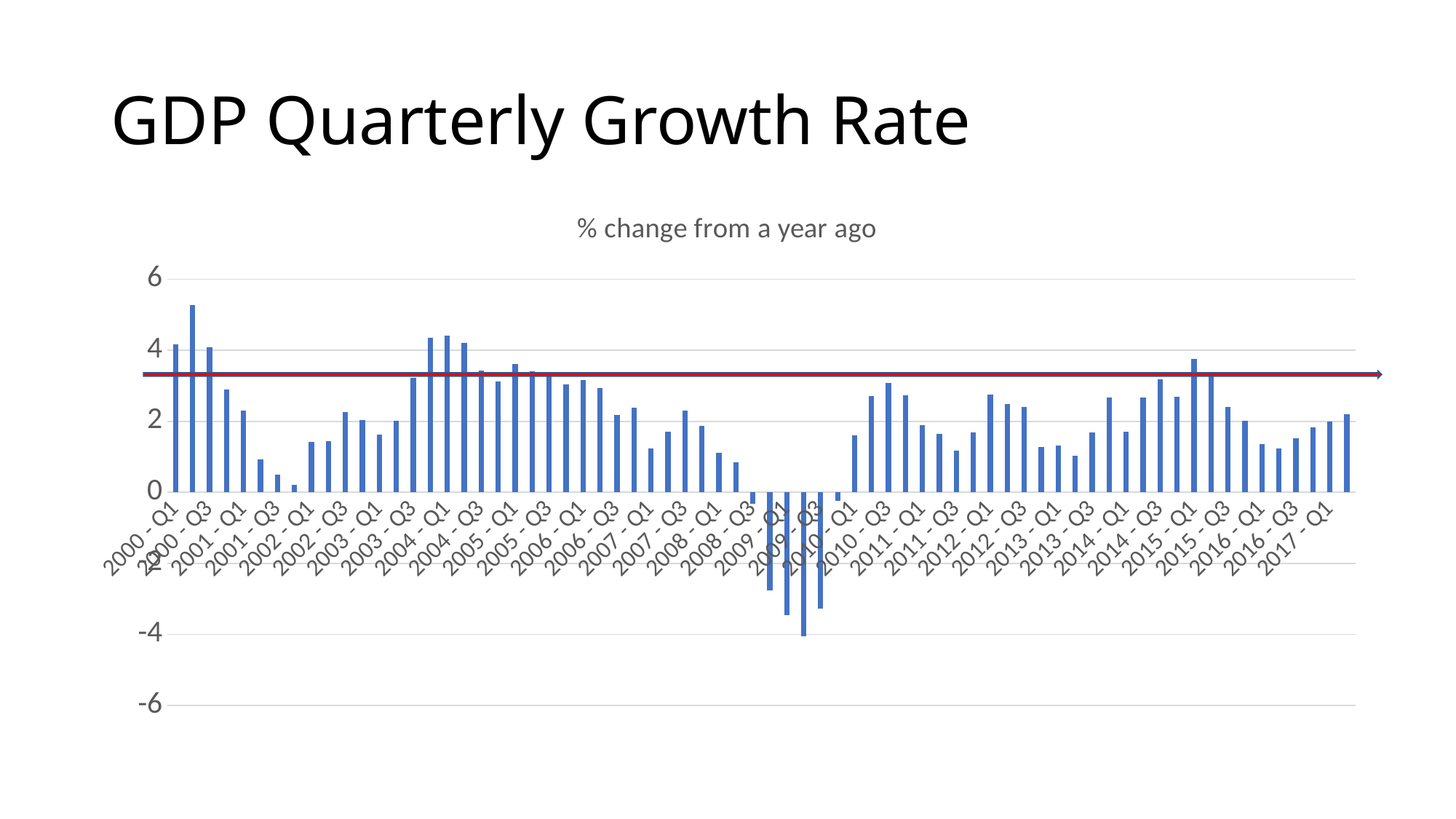
Which is larger, the value for 2000 - Q3 or the value for 2001 - Q1? 2000 - Q3 What is the title shown above the chart's plot area? % change from a year ago What kind of chart is shown on the slide? bar chart Do the values generally rise or fall from 2004 - Q1 to 2008 - Q3? fall Is the value for 2015 - Q1 greater or less than 2? greater Is the value for 2009 - Q3 greater or less than -2? less Is the value for 2002 - Q1 greater or less than 2? less Which quarter has the highest GDP growth rate in the chart? 2000 - Q2 Which quarter has the lowest GDP growth rate in the chart? 2009 - Q2 What colour is the horizontal line drawn across the chart? red